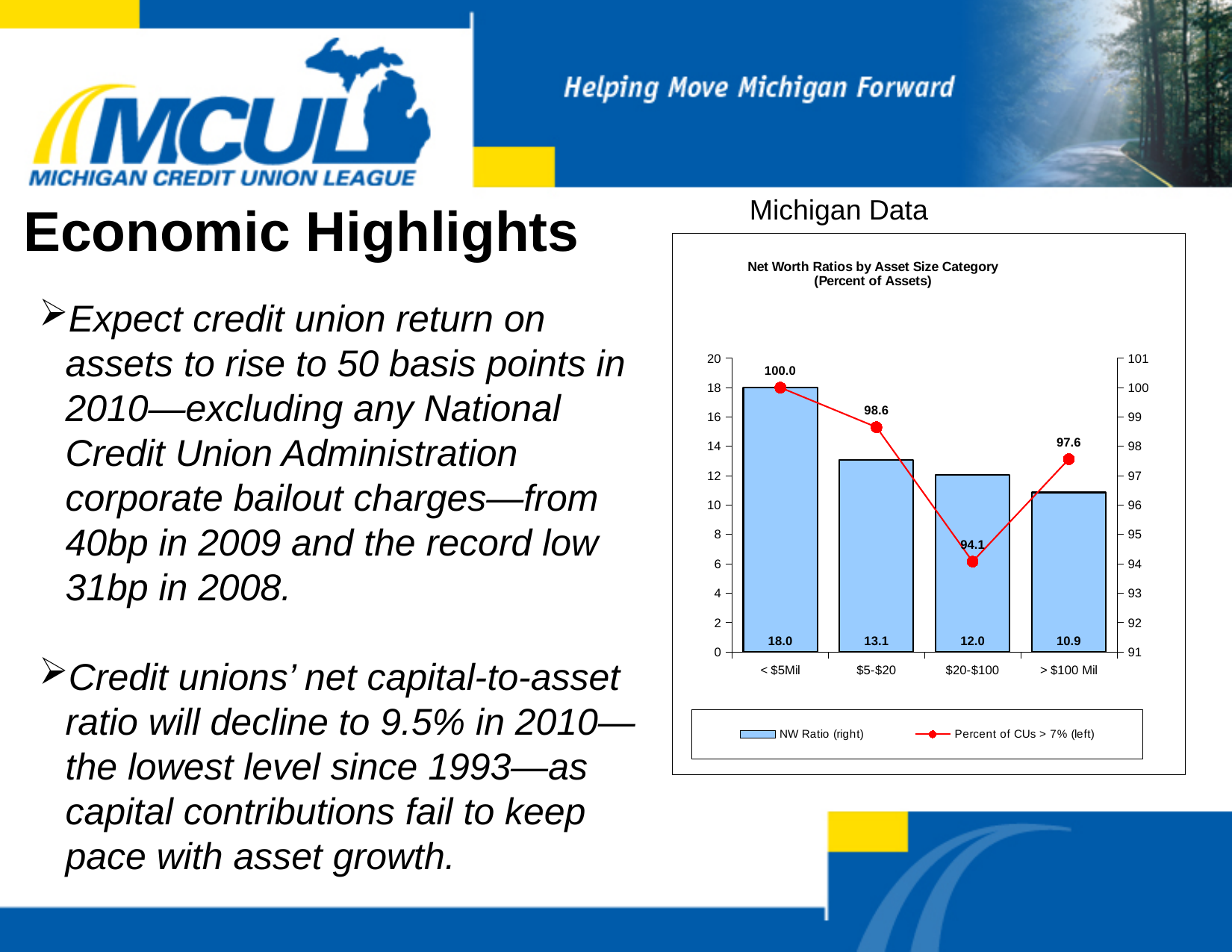
What is the Percent of CUs > 7% value for the $20-$100 category? 94.1 How many series does the legend list? 2 What is the difference between the NW Ratio for < $5Mil and for $5-$20? 4.9 Which is larger, the Percent of CUs > 7% for $5-$20 or for > $100 Mil? $5-$20 Which asset size category has the highest NW Ratio? < $5Mil What is the NW Ratio for the > $100 Mil asset size category? 10.9 How many asset size categories are shown on the x axis? 4 What is the title of the chart? Net Worth Ratios by Asset Size Category (Percent of Assets) Which asset size category has the lowest Percent of CUs > 7%? $20-$100 What is the NW Ratio for the < $5Mil asset size category? 18.0 What is the Percent of CUs > 7% value for the $5-$20 category? 98.6 Do the NW Ratio bars rise or fall from left to right across the asset size categories? fall